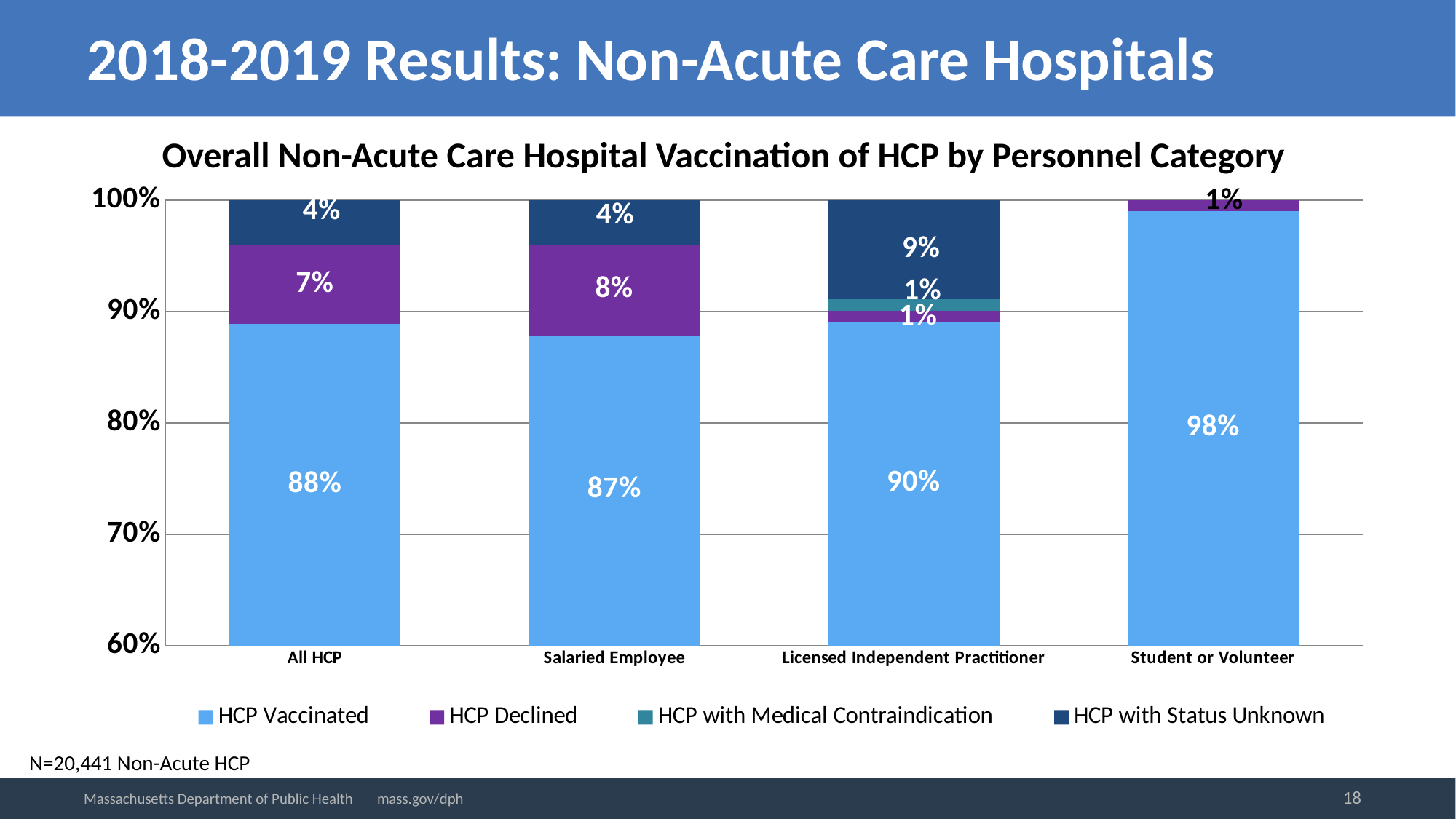
What percentage of All HCP were vaccinated? 88% How many personnel categories are shown on the x axis? 4 What is the difference between the HCP Vaccinated values for Student or Volunteer and Salaried Employee? 11% Which has a larger HCP with Status Unknown value, Licensed Independent Practitioner or All HCP? Licensed Independent Practitioner What is the HCP Declined value for Salaried Employee? 8% What type of chart is shown on the slide? stacked bar chart What is the title of the chart? Overall Non-Acute Care Hospital Vaccination of HCP by Personnel Category Which personnel category has the lowest HCP Vaccinated percentage? Salaried Employee What is the HCP Vaccinated value for Student or Volunteer? 98% Which personnel category has the highest HCP Vaccinated percentage? Student or Volunteer What is the HCP with Status Unknown value for Licensed Independent Practitioner? 9% How many series does the legend list? 4